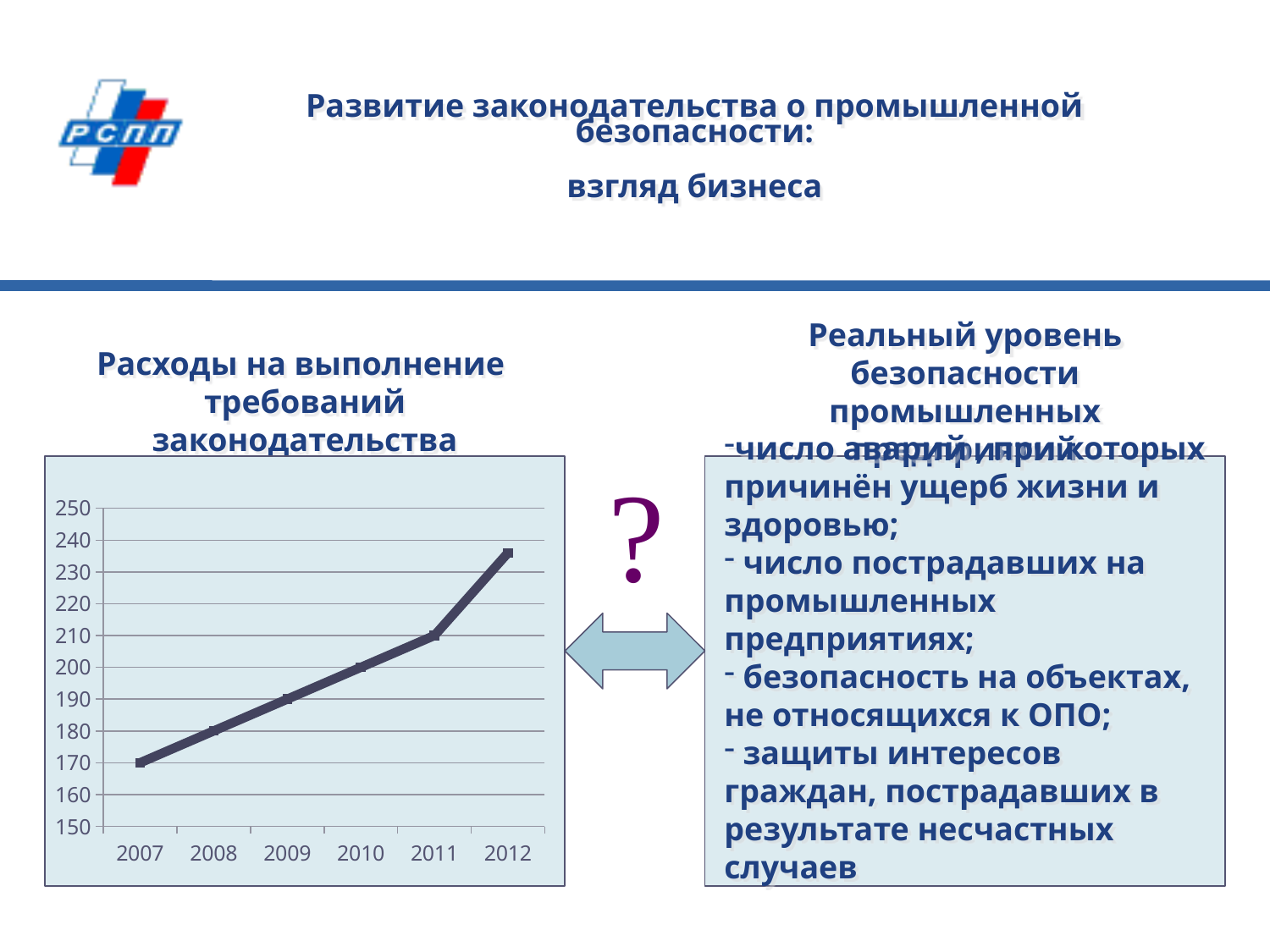
Do the values in the chart rise or fall from 2007 to 2012? rise Is the value for 2012 greater or less than 240? less Which year has the highest value in the chart? 2012 What is the title of the chart on the slide? Расходы на выполнение требований законодательства What is the value for 2010 in the chart? 200 What is the value for 2007 in the chart? 170 What kind of chart is shown on the slide? line chart What is the value for 2011 in the chart? 210 How many years are plotted on the x axis of the chart? 6 Which year has the lowest value in the chart? 2007 Is the value for 2012 greater or less than 230? greater Which is larger, the value for 2009 or the value for 2011? 2011